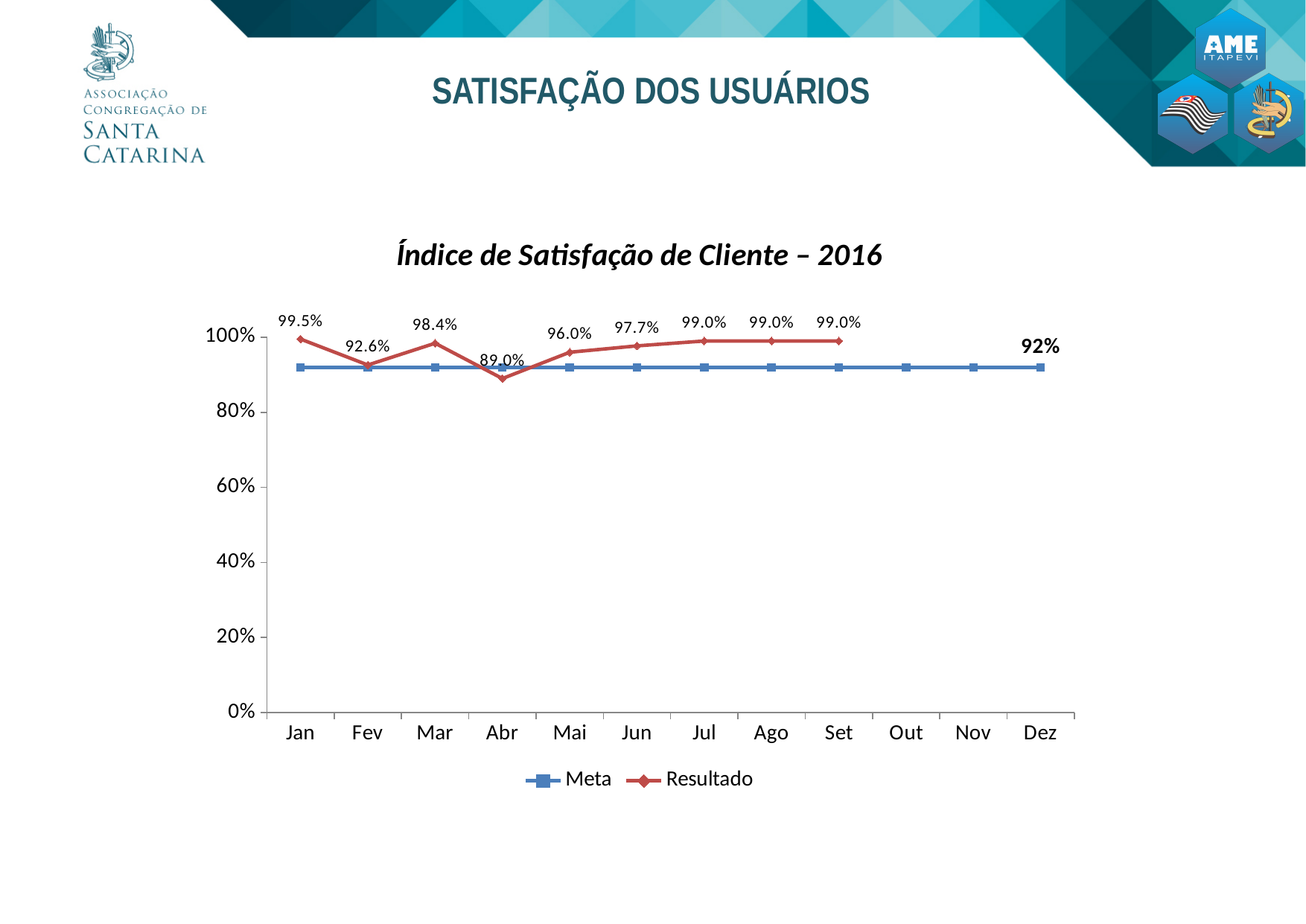
Is the Resultado value for Abr greater or less than 80%? greater What is the Resultado value for Jan? 99.5% How many months are shown on the x axis? 12 Which is larger, the Resultado value for Mai or for Jun? Jun What is the Resultado value for Abr? 89.0% Which month has the lowest Resultado value? Abr What is the difference between the Resultado values for Mar and Fev? 5.8% What is the title of the chart? Índice de Satisfação de Cliente – 2016 What is the Meta value shown on the chart? 92% What kind of chart is shown? line chart How many series does the legend list? 2 Which month has the highest Resultado value? Jan